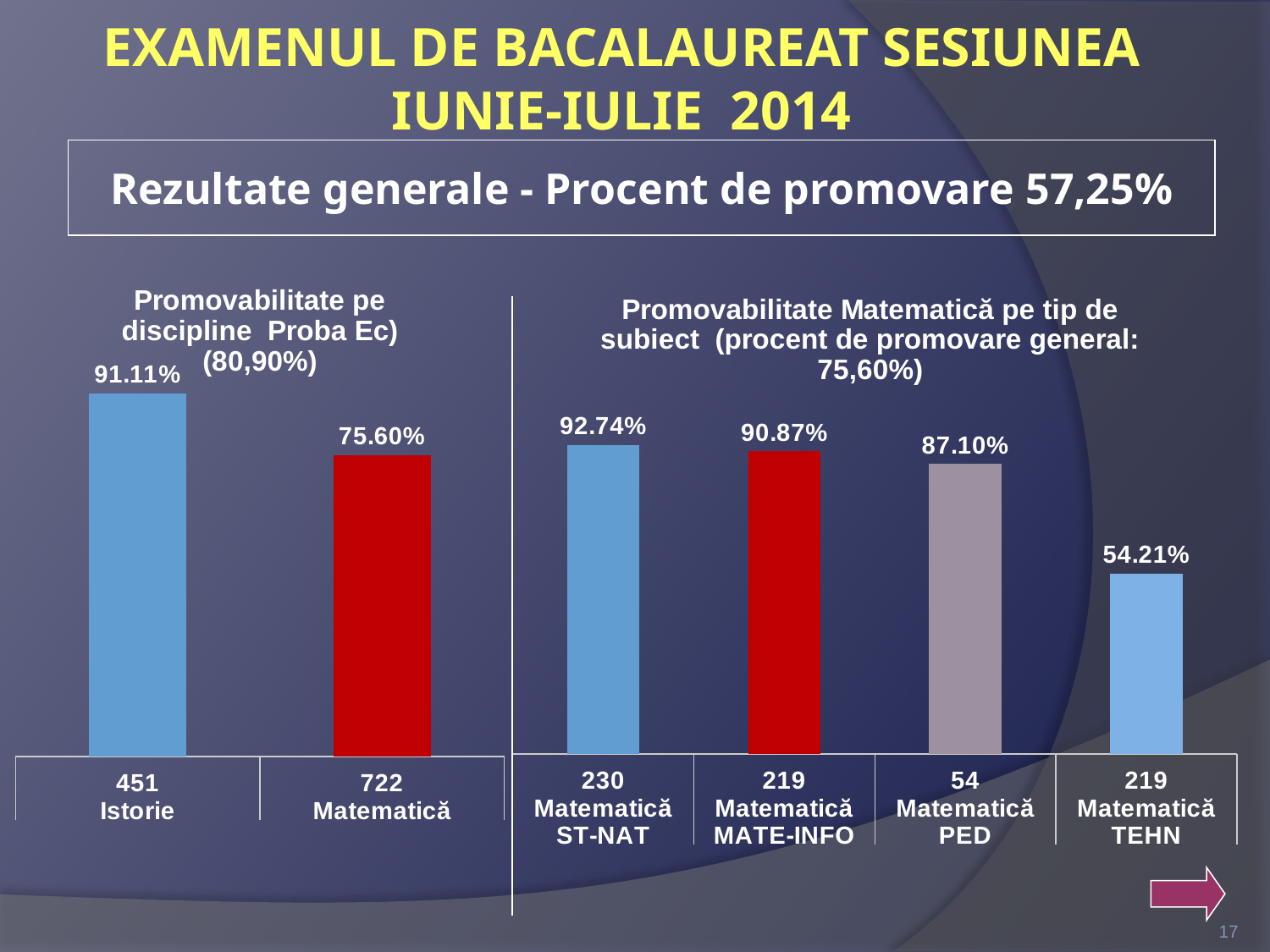
In the left chart (Promovabilitate pe discipline Proba Ec), what is the value for Matematică? 75.60% In the right chart (Promovabilitate Matematică pe tip de subiect), which category has the lowest value? Matematică TEHN In the left chart (Promovabilitate pe discipline Proba Ec), what is the difference between the Istorie and Matematică values? 15.51 percentage points In the right chart (Promovabilitate Matematică pe tip de subiect), what is the value for Matematică ST-NAT? 92.74% In the left chart (Promovabilitate pe discipline Proba Ec), how many categories are plotted? 2 In the right chart (Promovabilitate Matematică pe tip de subiect), what is the value for Matematică PED? 87.10% In the left chart (Promovabilitate pe discipline Proba Ec), what is the value for Istorie? 91.11% In the left chart (Promovabilitate pe discipline Proba Ec), which category has the higher value? Istorie What kind of chart is the right chart (Promovabilitate Matematică pe tip de subiect)? Bar chart In the right chart (Promovabilitate Matematică pe tip de subiect), which category has the highest value? Matematică ST-NAT In the right chart (Promovabilitate Matematică pe tip de subiect), how many categories are plotted? 4 In the right chart (Promovabilitate Matematică pe tip de subiect), what is the difference between the Matematică ST-NAT and Matematică TEHN values? 38.53 percentage points